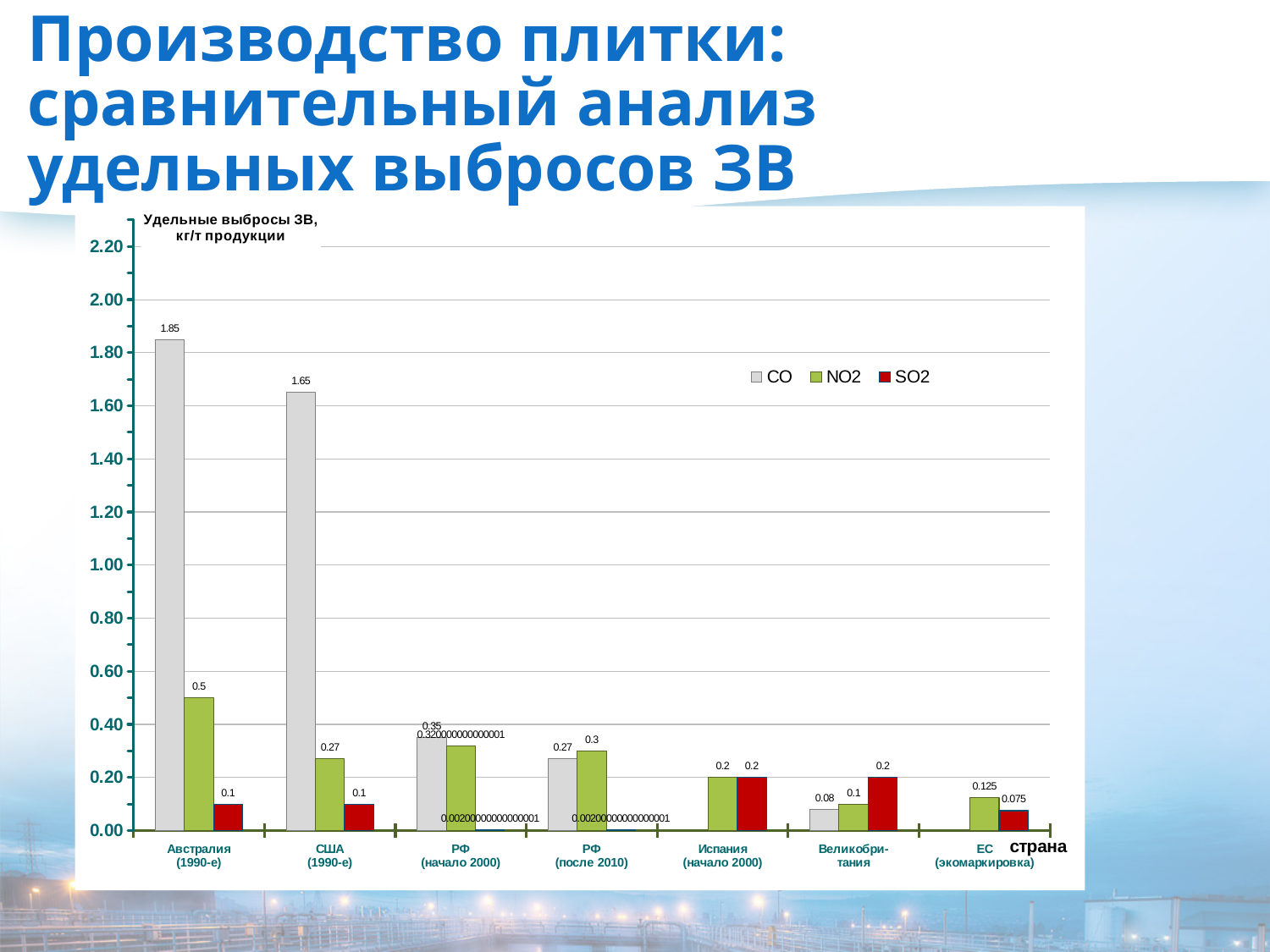
Which category has the highest CO value? Австралия (1990-е) What is the NO2 value for ЕС (экомаркировка)? 0.125 How many countries/categories are shown on the x axis? 7 What kind of chart is shown on the slide? bar chart What is the SO2 value for Великобритания? 0.2 What is the difference between the CO values for Австралия (1990-е) and США (1990-е)? 0.2 What is the y-axis label of the chart? Удельные выбросы ЗВ, кг/т продукции Which is larger: the NO2 value for США (1990-е) or the NO2 value for РФ (после 2010)? РФ (после 2010) What is the CO value for Австралия (1990-е)? 1.85 What is the CO value for США (1990-е)? 1.65 What is the NO2 value for Австралия (1990-е)? 0.5 How many series does the legend list? 3